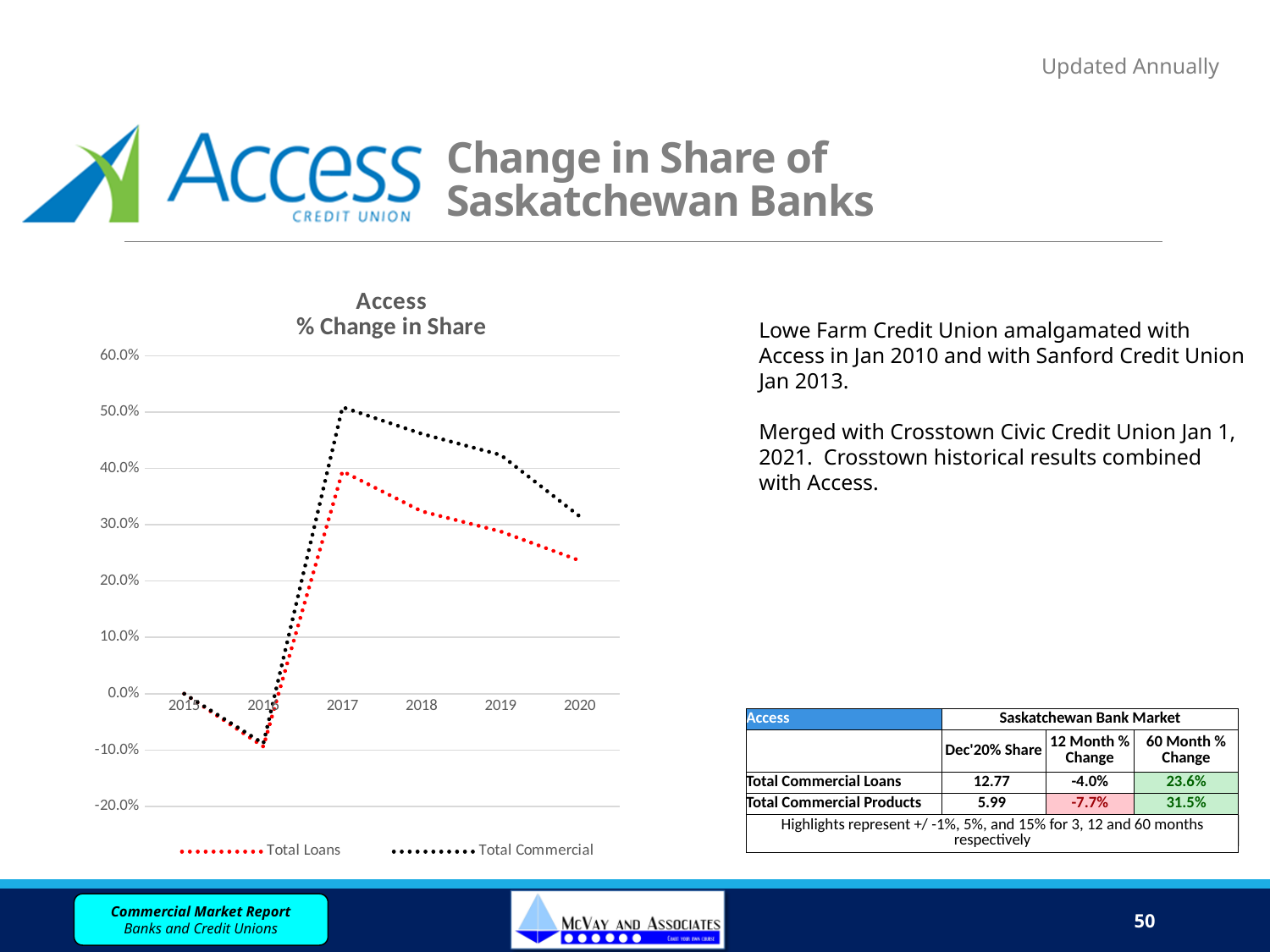
What is the title of the chart? Access % Change in Share In 2018, which series has the higher value, Total Loans or Total Commercial? Total Commercial Is the value for Total Commercial in 2020 greater or less than 40.0%? less In which year does the Total Commercial series reach its highest value? 2017 Is the value for Total Loans in 2020 greater or less than 30.0%? less How many years are shown on the x axis of the chart? 6 Is the value for Total Commercial in 2017 greater or less than 40.0%? greater What are the two series named in the chart legend? Total Loans and Total Commercial What kind of chart is shown on the slide? line chart How many series does the legend of the chart list? 2 From 2017 to 2020, does the Total Loans series rise or fall? fall In which year does the Total Loans series reach its lowest value? 2016